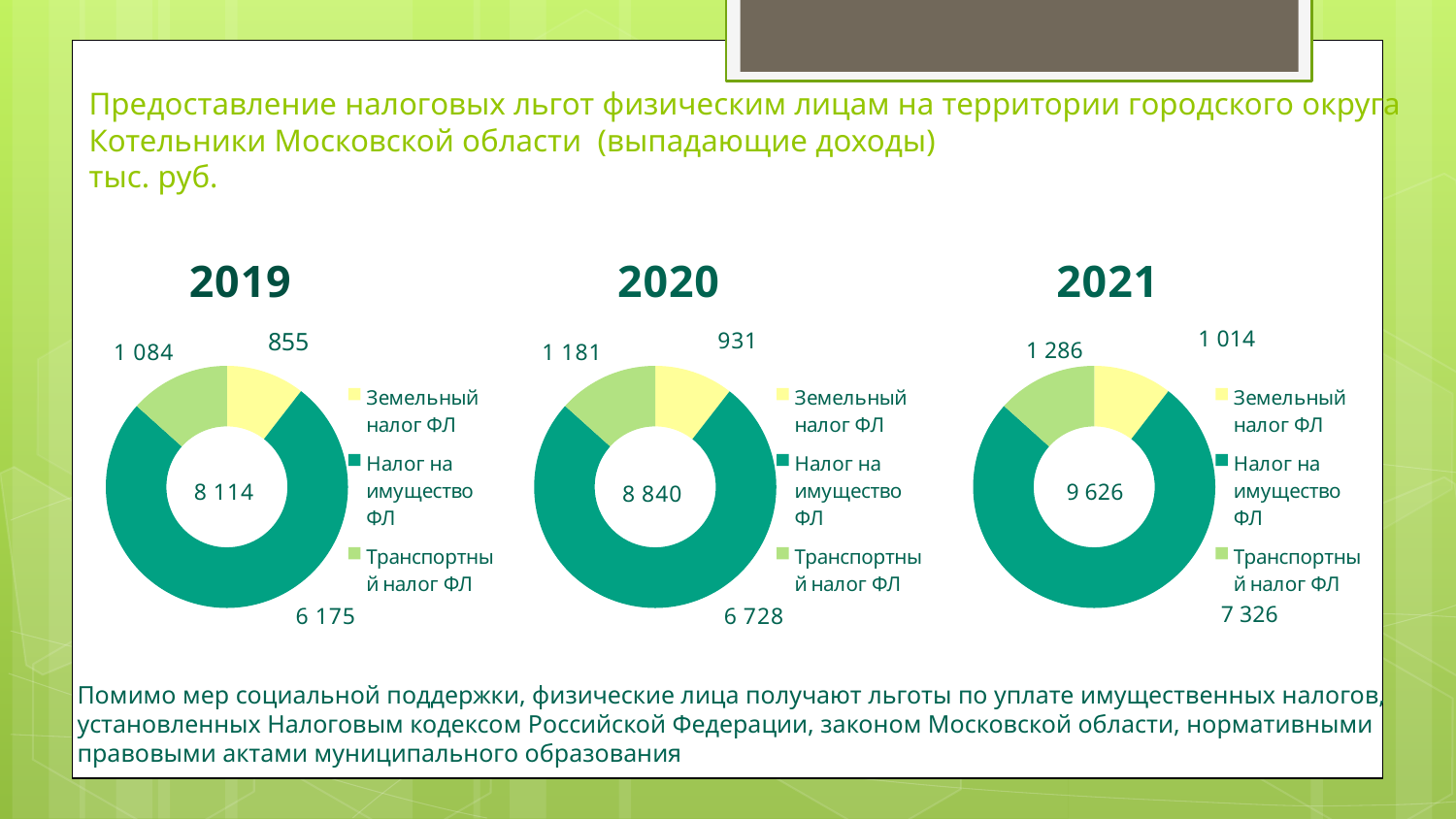
What is the total shown in the centre of the 2020 chart? 8 840 How many charts are on the slide? 3 What is the difference between the Транспортный налог ФЛ value in the 2020 chart and in the 2019 chart? 97 What is the difference between the Налог на имущество ФЛ value in the 2021 chart and in the 2019 chart? 1 151 Which is larger: Транспортный налог ФЛ in the 2020 chart or Земельный налог ФЛ in the 2021 chart? Транспортный налог ФЛ in the 2020 chart In the 2021 chart, which category has the largest value? Налог на имущество ФЛ How many categories does each chart show? 3 In the 2019 chart, which category has the smallest value? Земельный налог ФЛ What kind of chart is used for 2019, 2020 and 2021? Doughnut chart In the 2020 chart, what is the value for Земельный налог ФЛ? 931 In the 2021 chart, what is the value for Транспортный налог ФЛ? 1 286 In the 2019 chart, what is the value for Налог на имущество ФЛ? 6 175